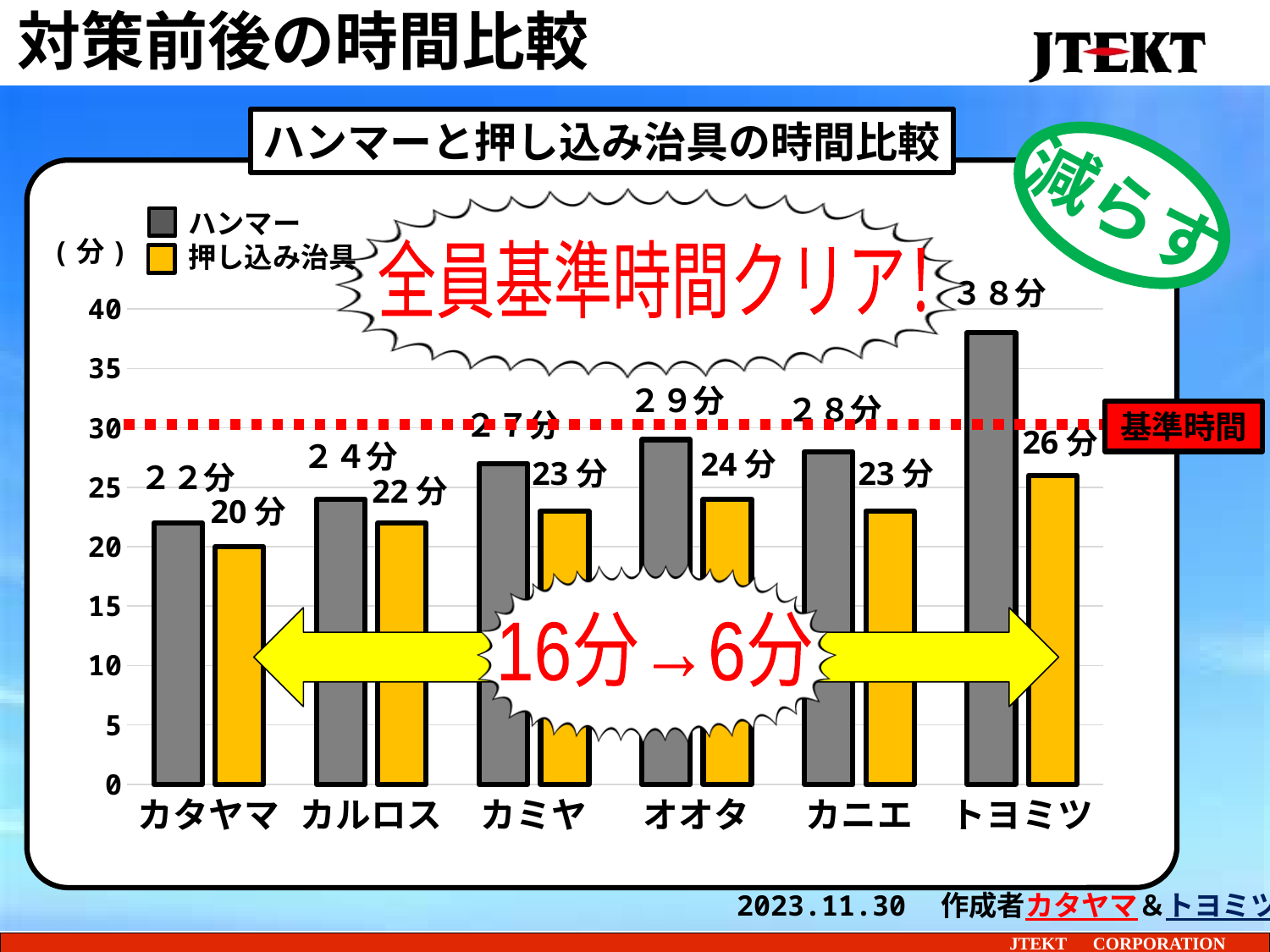
How many series does the legend list? 2 Which is larger, the ハンマー value for カミヤ or the ハンマー value for オオタ? オオタ How many people (categories) are shown on the x axis? 6 What is the ハンマー value for カニエ? 28分 What is the 押し込み治具 value for オオタ? 24分 Which person has the highest ハンマー value? トヨミツ At what value is the 基準時間 dotted line drawn? 30 Is the ハンマー value for トヨミツ greater or less than 30? greater Which person has the lowest 押し込み治具 value? カタヤマ What kind of chart is shown on the slide? bar chart What is the ハンマー value for トヨミツ? 38分 For トヨミツ, what is the difference between the ハンマー value and the 押し込み治具 value? 12分